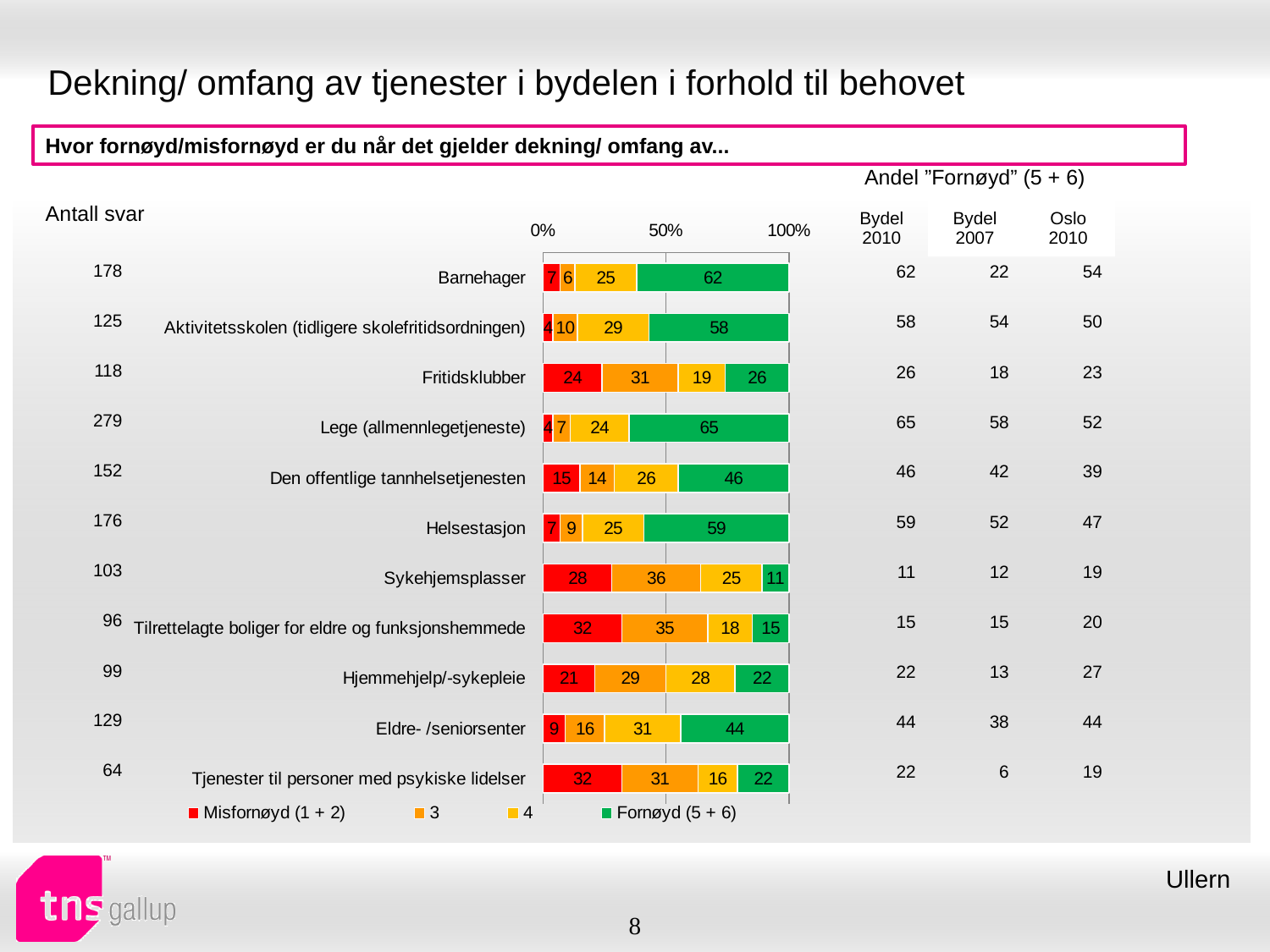
Which has the larger Misfornøyd (1 + 2) value, Fritidsklubber or Hjemmehjelp/-sykepleie? Fritidsklubber Which category has the lowest Fornøyd (5 + 6) value? Sykehjemsplasser What is the difference between the Fornøyd (5 + 6) values for Barnehager and Fritidsklubber? 36 What is the total of the stacked bar for Fritidsklubber? 100 What is the value of the Fornøyd (5 + 6) segment for Lege (allmennlegetjeneste)? 65 What kind of chart is shown on the slide? Stacked bar chart What is the value of the '3' segment for Tilrettelagte boliger for eldre og funksjonshemmede? 35 How many series does the legend list? 4 What colour represents Fornøyd (5 + 6) in the legend? Green What is the value of the Misfornøyd (1 + 2) segment for Sykehjemsplasser? 28 How many categories are shown in the chart? 11 Which category has the highest Fornøyd (5 + 6) value? Lege (allmennlegetjeneste)